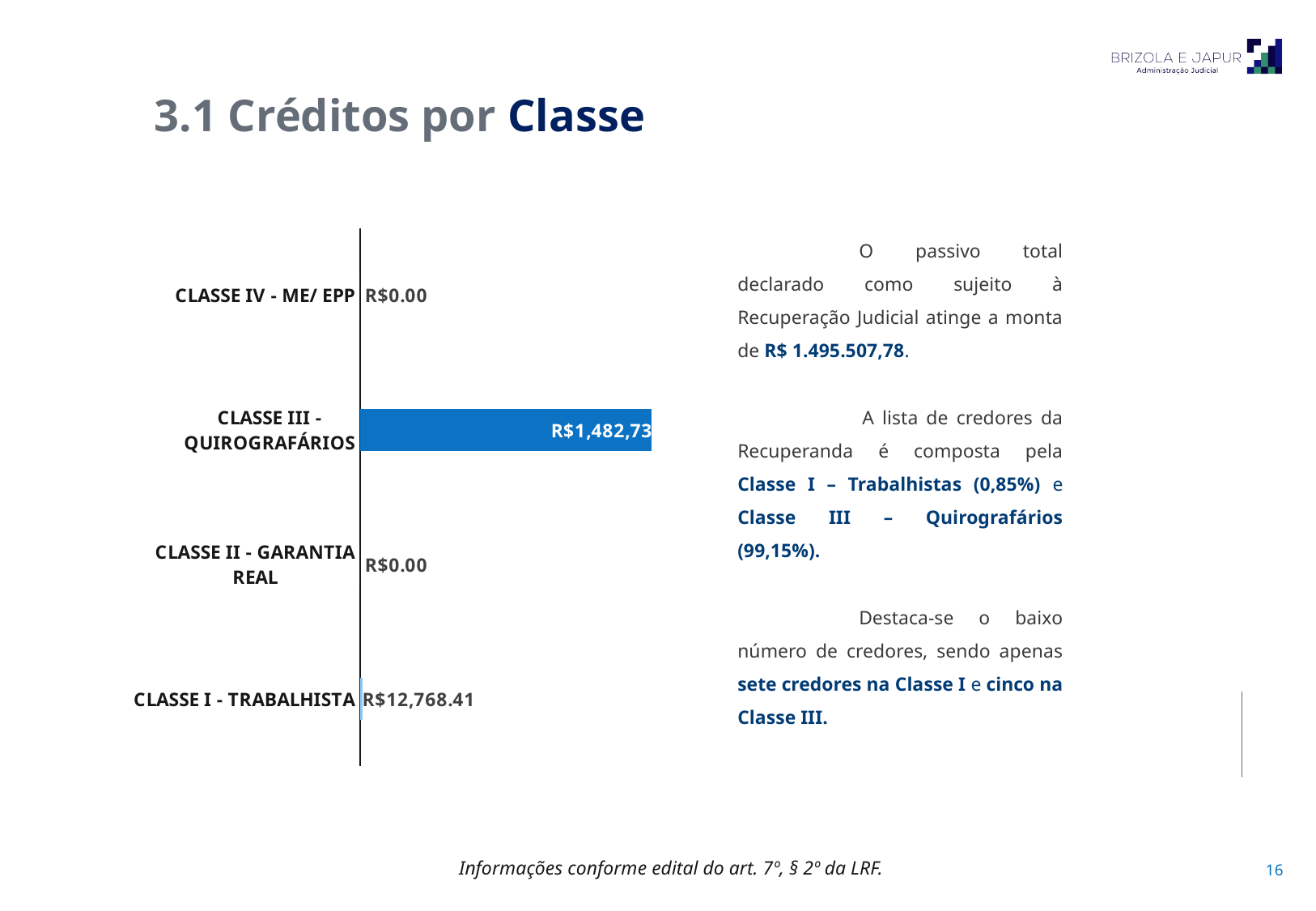
What value is shown for CLASSE IV - ME/ EPP? R$0.00 What value is shown for CLASSE I - TRABALHISTA? R$12,768.41 How many classes are shown in the chart? 4 What colour is the bar for CLASSE III - QUIROGRAFÁRIOS? Blue What value is shown for CLASSE II - GARANTIA REAL? R$0.00 Which class has the highest value in the chart? CLASSE III - QUIROGRAFÁRIOS What is the difference between the values for CLASSE I - TRABALHISTA and CLASSE II - GARANTIA REAL? R$12,768.41 Which is larger, the value for CLASSE I - TRABALHISTA or for CLASSE II - GARANTIA REAL? CLASSE I - TRABALHISTA What kind of chart is shown on the slide? Bar chart How many classes in the chart have a value of R$0.00? 2 Which is larger, the value for CLASSE III - QUIROGRAFÁRIOS or for CLASSE I - TRABALHISTA? CLASSE III - QUIROGRAFÁRIOS What is the title of the slide containing the chart? 3.1 Créditos por Classe